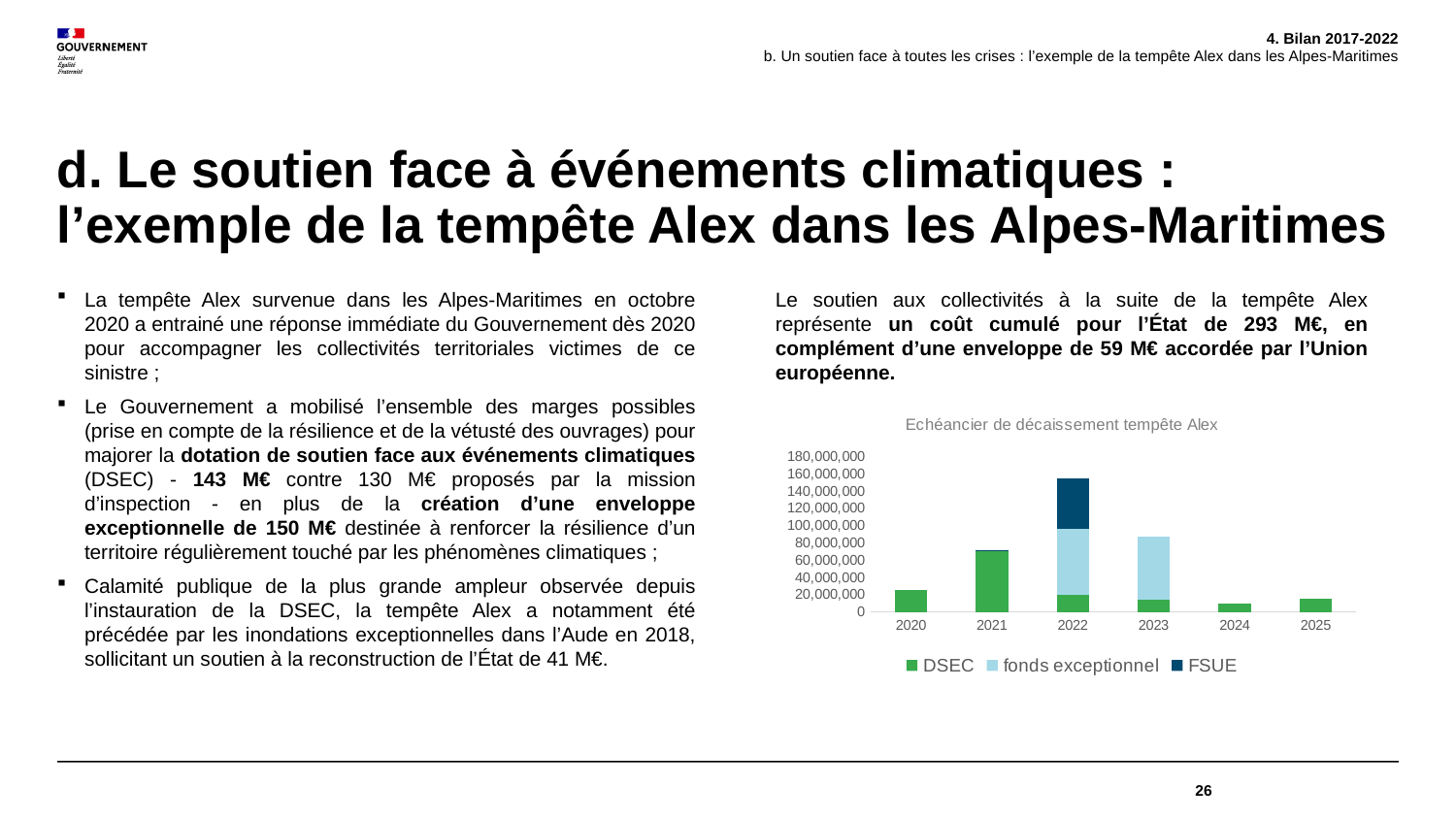
How many series does the chart legend list? 3 What is the title of the chart? Echéancier de décaissement tempête Alex Which year has a larger total bar, 2021 or 2023? 2023 How many years are shown on the x axis of the chart? 6 Is the total value for 2022 greater or less than 140,000,000? greater In which year does the FSUE series appear in the chart? 2022 Which year has a larger bar, 2020 or 2021? 2021 Is the value for 2020 greater or less than 40,000,000? less Is the total value for 2023 greater or less than 100,000,000? less What type of chart is shown on the slide? Stacked bar chart Which year has the highest total bar in the chart? 2022